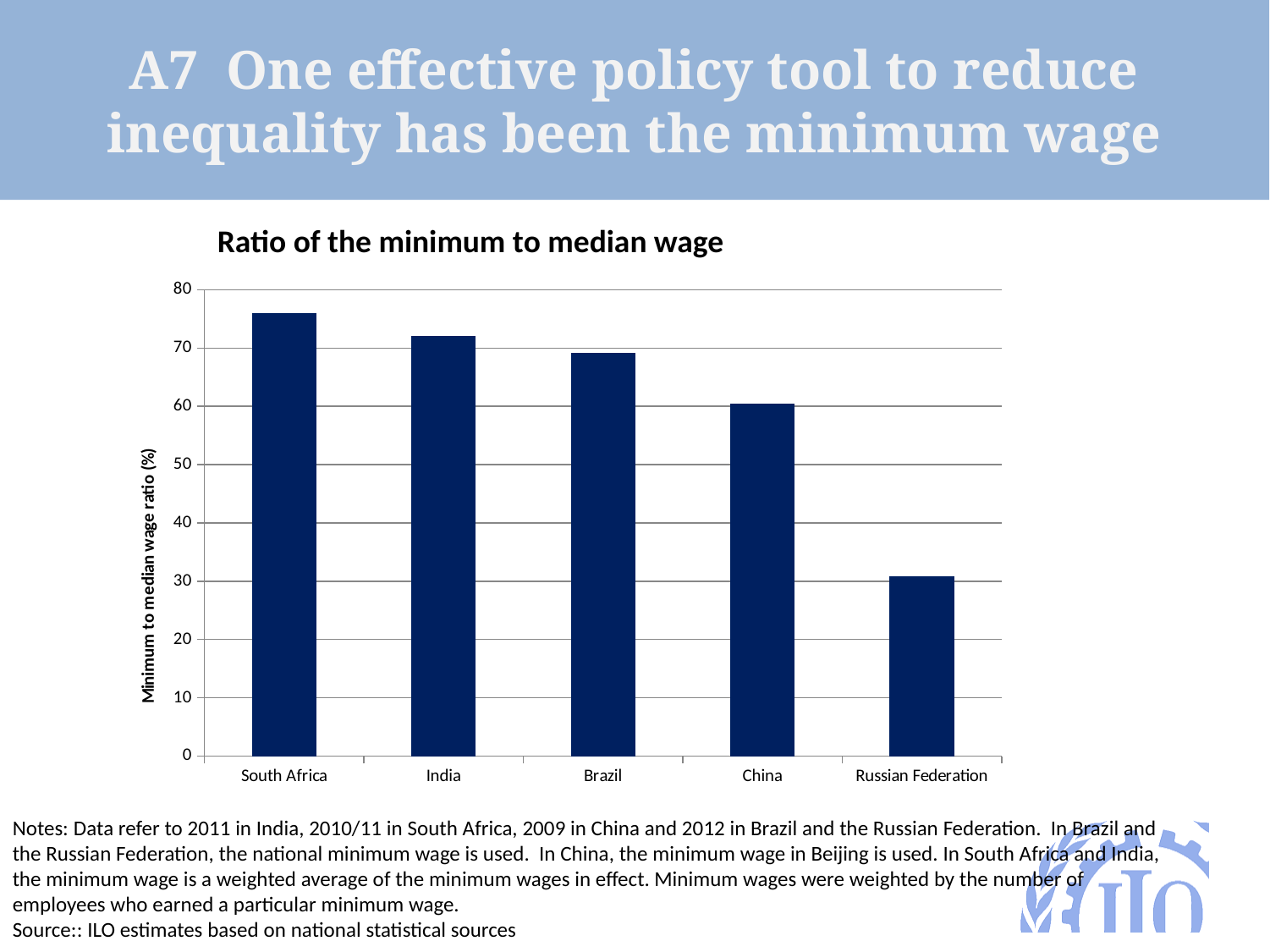
Is the value for Russian Federation greater or less than 40? less Which has a higher minimum to median wage ratio, India or China? India Is the value for South Africa greater or less than 70? greater What kind of chart is shown on the slide? bar chart Do the values rise or fall moving from left to right across the countries? fall Which country has the highest minimum to median wage ratio? South Africa Which country has the lowest minimum to median wage ratio? Russian Federation What is the title of the chart? Ratio of the minimum to median wage Is the value for China greater or less than 70? less How many countries are shown in the chart? 5 What is the label of the vertical axis? Minimum to median wage ratio (%)